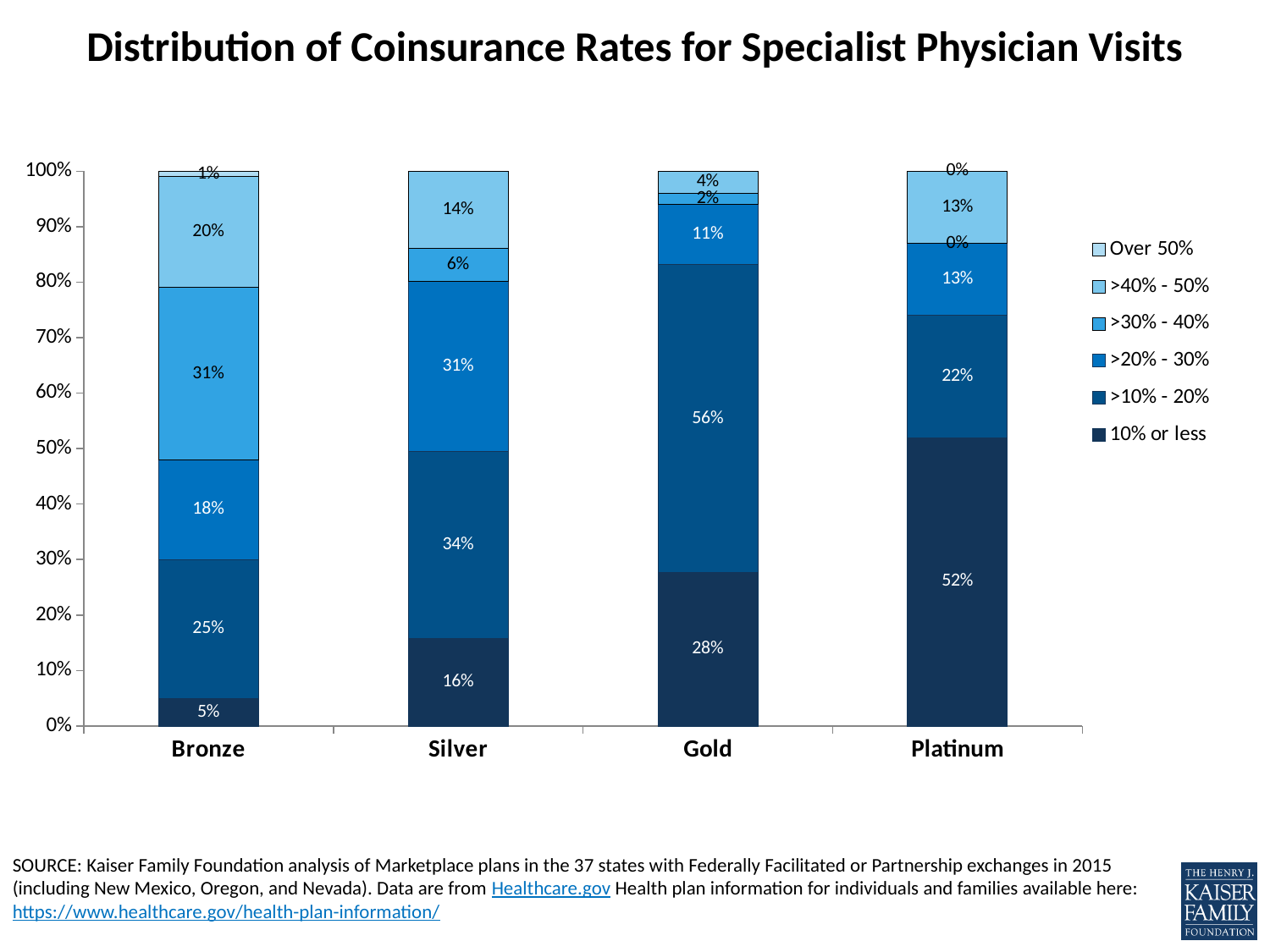
How many percentage points higher is the 10% or less share for Gold than for Silver? 12 percentage points What percentage of Platinum plans have a coinsurance rate of 10% or less for specialist physician visits? 52% How many plan tiers are shown on the x axis? 4 What percentage of Gold plans fall in the >10% - 20% coinsurance category? 56% What is the title of the chart? Distribution of Coinsurance Rates for Specialist Physician Visits What percentage of Silver plans fall in the >40% - 50% coinsurance category? 14% Which plan tier has the lowest share of plans with coinsurance of 10% or less? Bronze Which plan tier has the highest share of plans with coinsurance of 10% or less? Platinum Which has a larger share in the >10% - 20% category, Silver or Bronze? Silver What percentage of Bronze plans fall in the >30% - 40% coinsurance category? 31% How many coinsurance categories does the legend list? 6 What type of chart is shown on the slide? Stacked bar chart